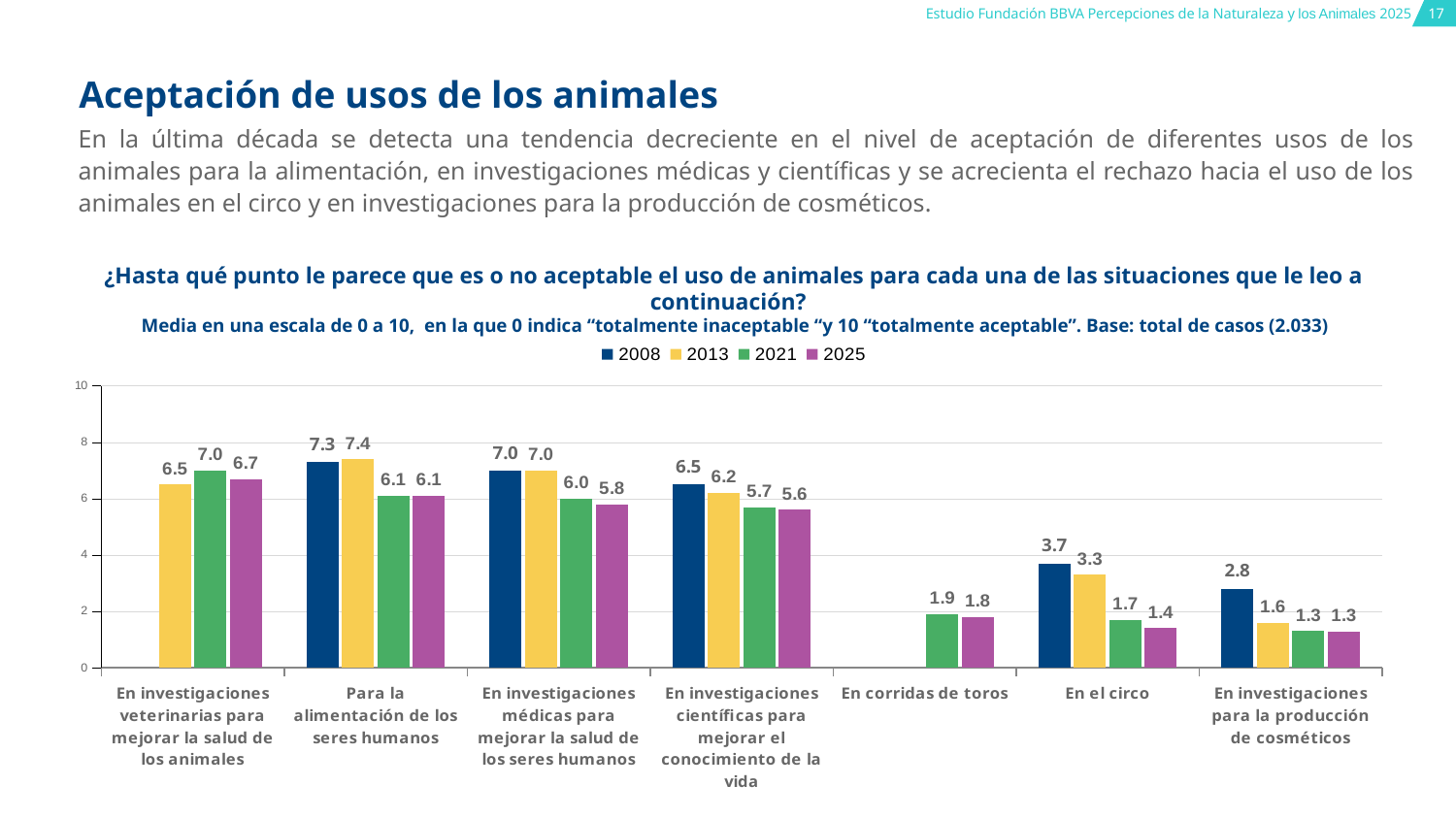
What kind of chart is shown on the slide? bar chart What is the 2021 value for "En corridas de toros"? 1.9 Is the 2013 value for "En el circo" greater or less than 4? less Which is larger for "En investigaciones científicas para mejorar el conocimiento de la vida": the 2008 value or the 2025 value? 2008 Which category has the lowest 2008 value? En investigaciones para la producción de cosméticos How many series does the legend list? 4 What is the 2008 value for "Para la alimentación de los seres humanos"? 7.3 What is the difference between the 2008 and 2025 values for "En investigaciones para la producción de cosméticos"? 1.5 Which category has the highest 2025 value? En investigaciones veterinarias para mejorar la salud de los animales Do the values for "En investigaciones médicas para mejorar la salud de los seres humanos" rise or fall from 2008 to 2025? fall What is the 2025 value for "En el circo"? 1.4 How many categories are shown on the x axis? 7